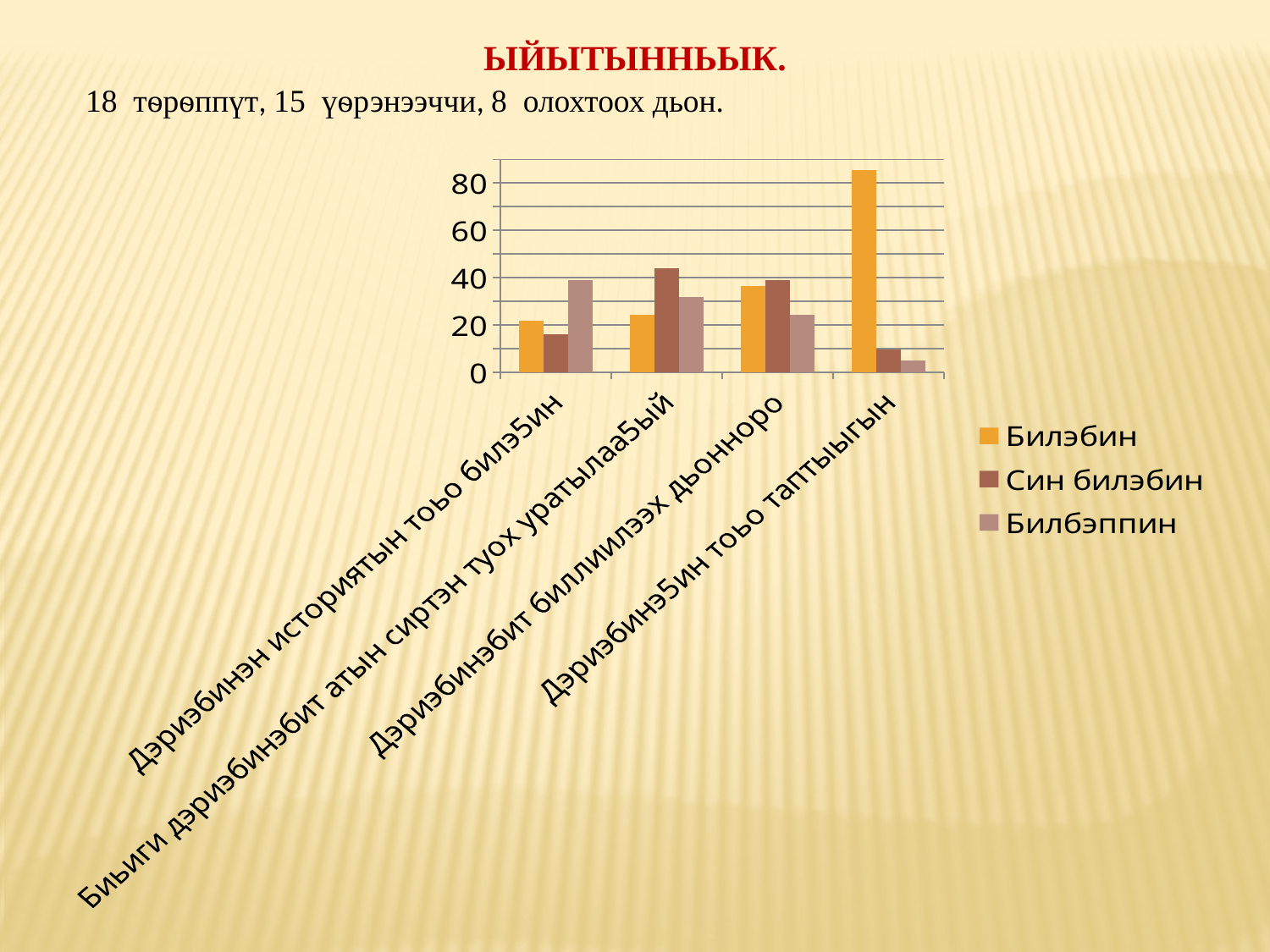
What colour are the Билэбин bars? orange For Дэриэбинэн историятын тоьо билэ5ин, which is larger: Билэбин or Билбэппин? Билбэппин Is the Билбэппин value for Дэриэбинэ5ин тоьо таптыыгын greater or less than 20? less How many series does the legend list? 3 Which series has the lowest bar for Дэриэбинэ5ин тоьо таптыыгын? Билбэппин For Дэриэбинэбит биллиилээх дьонноро, which is larger: Билэбин or Билбэппин? Билэбин Is the Билэбин value for Дэриэбинэ5ин тоьо таптыыгын greater or less than 80? greater Which category has the highest Билэбин bar? Дэриэбинэ5ин тоьо таптыыгын What kind of chart is shown on the slide? bar chart How many categories are shown on the x axis? 4 Is the Син билэбин value for Дэриэбинэн историятын тоьо билэ5ин greater or less than 20? less